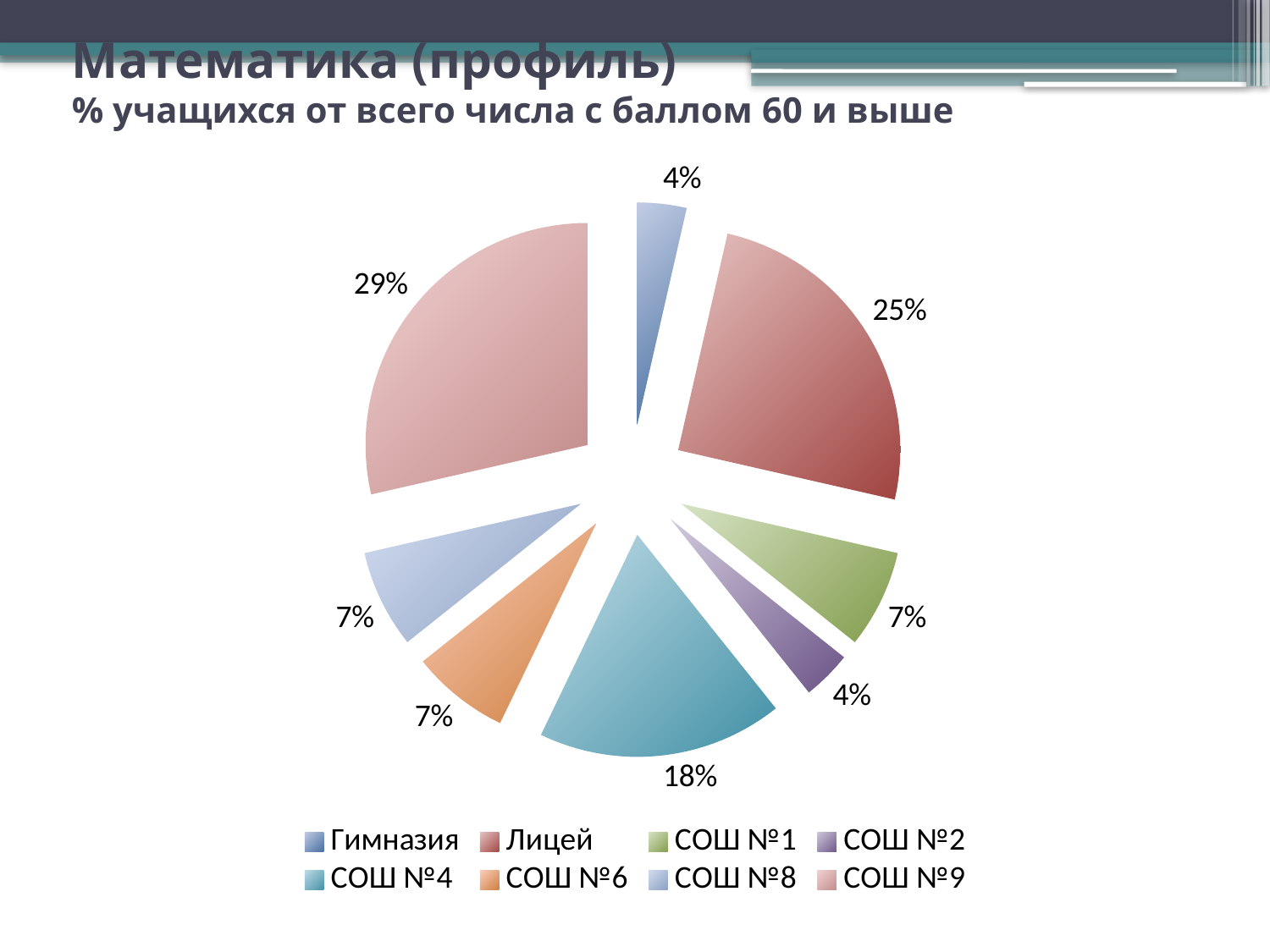
What percentage does the pie chart show for СОШ №9? 29% What percentage does the pie chart show for СОШ №6? 7% What percentage does the pie chart show for СОШ №2? 4% What percentage does the pie chart show for СОШ №4? 18% What is the difference in percentage points between СОШ №9 and Лицей? 4 What percentage does the pie chart show for Лицей? 25% How many slices does the pie chart have? 8 Which has a larger share, Лицей or СОШ №4? Лицей What percentage does the pie chart show for Гимназия? 4% What is the title of the chart on the slide? Математика (профиль) % учащихся от всего числа с баллом 60 и выше What type of chart is shown on the slide? Pie chart Which school has the largest slice of the pie chart? СОШ №9